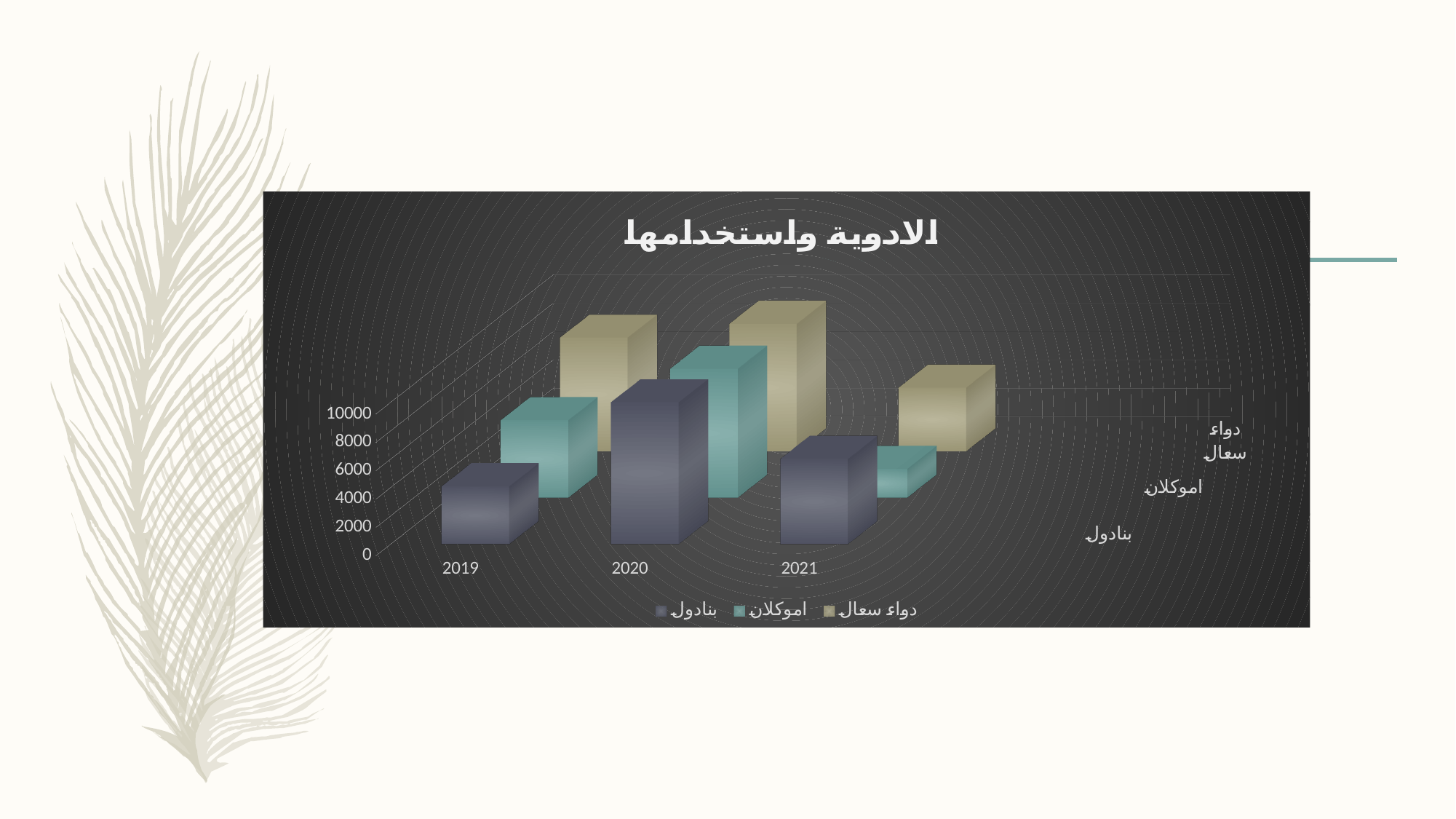
Is the value for بنادول in 2020 greater or less than 6000? greater Which series is shown in the dark blue-grey colour in the legend? بنادول In which year is the value for بنادول highest? 2020 What kind of chart is shown on the slide? bar chart Does the value for بنادول rise or fall from 2020 to 2021? fall Is the value for بنادول in 2019 greater or less than 6000? less In which year is the value for اموكلان lowest? 2021 Which is larger, the value for اموكلان in 2020 or in 2021? 2020 What is the title of the chart? الادوية واستخدامها How many years are shown on the x axis of the chart? 3 In which year is the value for دواء سعال highest? 2020 How many series does the legend list? 3